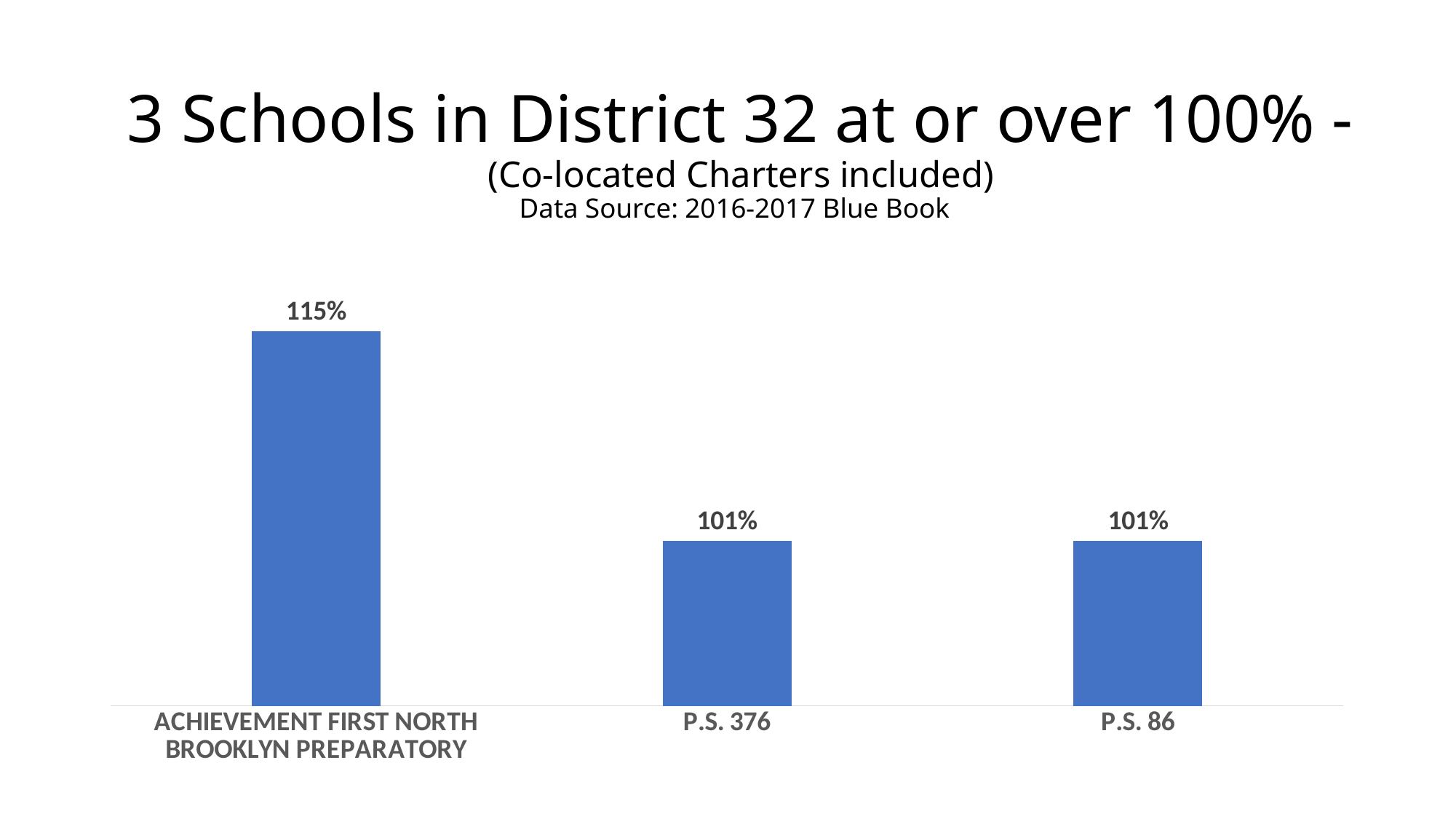
What data source is cited on the slide? 2016-2017 Blue Book Which is larger, the value for Achievement First North Brooklyn Preparatory or the value for P.S. 86? Achievement First North Brooklyn Preparatory Do P.S. 376 and P.S. 86 have the same value? Yes What is the difference between the values for Achievement First North Brooklyn Preparatory and P.S. 376? 14% What is the value for P.S. 376? 101% Which school has the highest value? Achievement First North Brooklyn Preparatory What kind of chart is shown on the slide? Bar chart What is the title of the chart on the slide? 3 Schools in District 32 at or over 100% - (Co-located Charters included) What is the value for P.S. 86? 101% What is the value for Achievement First North Brooklyn Preparatory? 115% How many schools are shown in the chart? 3 Do the values rise or fall from the first bar to the second bar? Fall